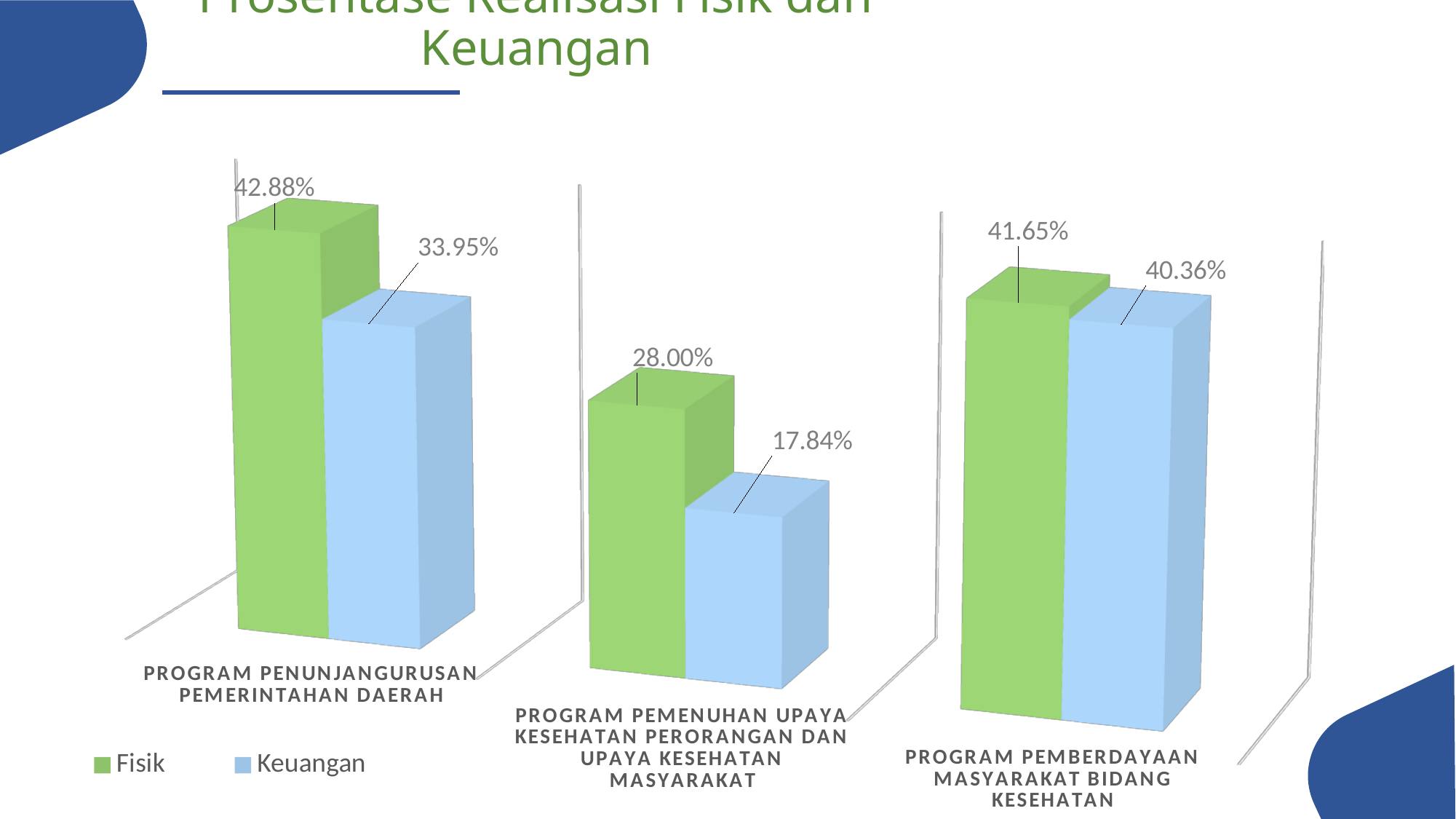
What is the Keuangan value for Program Pemberdayaan Masyarakat Bidang Kesehatan? 40.36% What is the difference between the Fisik and Keuangan values for Program Pemenuhan Upaya Kesehatan Perorangan dan Upaya Kesehatan Masyarakat? 10.16 percentage points What is the Keuangan value for Program Penunjang Urusan Pemerintahan Daerah? 33.95% Which program has the highest Fisik value? Program Penunjang Urusan Pemerintahan Daerah What kind of chart is shown on the slide? Bar chart Which program has the lowest Keuangan value? Program Pemenuhan Upaya Kesehatan Perorangan dan Upaya Kesehatan Masyarakat What is the Keuangan value for Program Pemenuhan Upaya Kesehatan Perorangan dan Upaya Kesehatan Masyarakat? 17.84% How many series does the legend list? 2 For Program Penunjang Urusan Pemerintahan Daerah, which is larger, Fisik or Keuangan? Fisik What is the Fisik value for Program Penunjang Urusan Pemerintahan Daerah? 42.88% What is the Fisik value for Program Pemberdayaan Masyarakat Bidang Kesehatan? 41.65% What is the Fisik value for Program Pemenuhan Upaya Kesehatan Perorangan dan Upaya Kesehatan Masyarakat? 28.00%